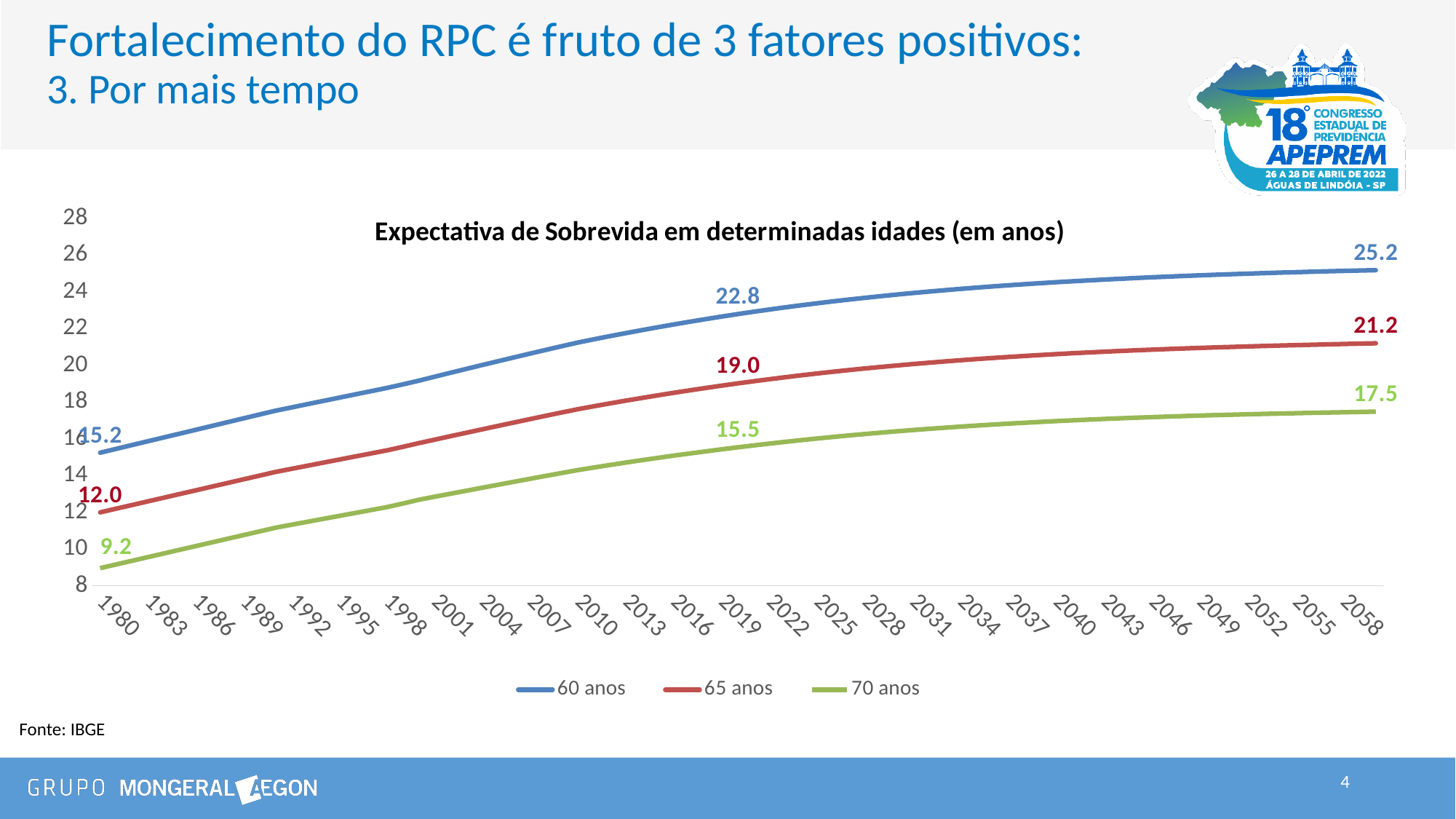
Do the values of the 70 anos series rise or fall from 1980 to 2058? rise Which series has the highest values across the chart? 60 anos What is the title of the chart? Expectativa de Sobrevida em determinadas idades (em anos) What is the difference between the 60 anos value in 2019 (22.8) and its value in 1980 (15.2)? 7.6 What is the value for the 65 anos series in 1980? 12.0 What is the final labelled value of the 70 anos series at the right end of the chart? 17.5 What is the value for the 70 anos series in 1980? 9.2 What is the value for the 60 anos series in 2019? 22.8 What is the final labelled value of the 65 anos series at the right end of the chart? 21.2 What type of chart is shown on the slide? line chart How many series does the legend list? 3 What is the value for the 60 anos series in 1980? 15.2